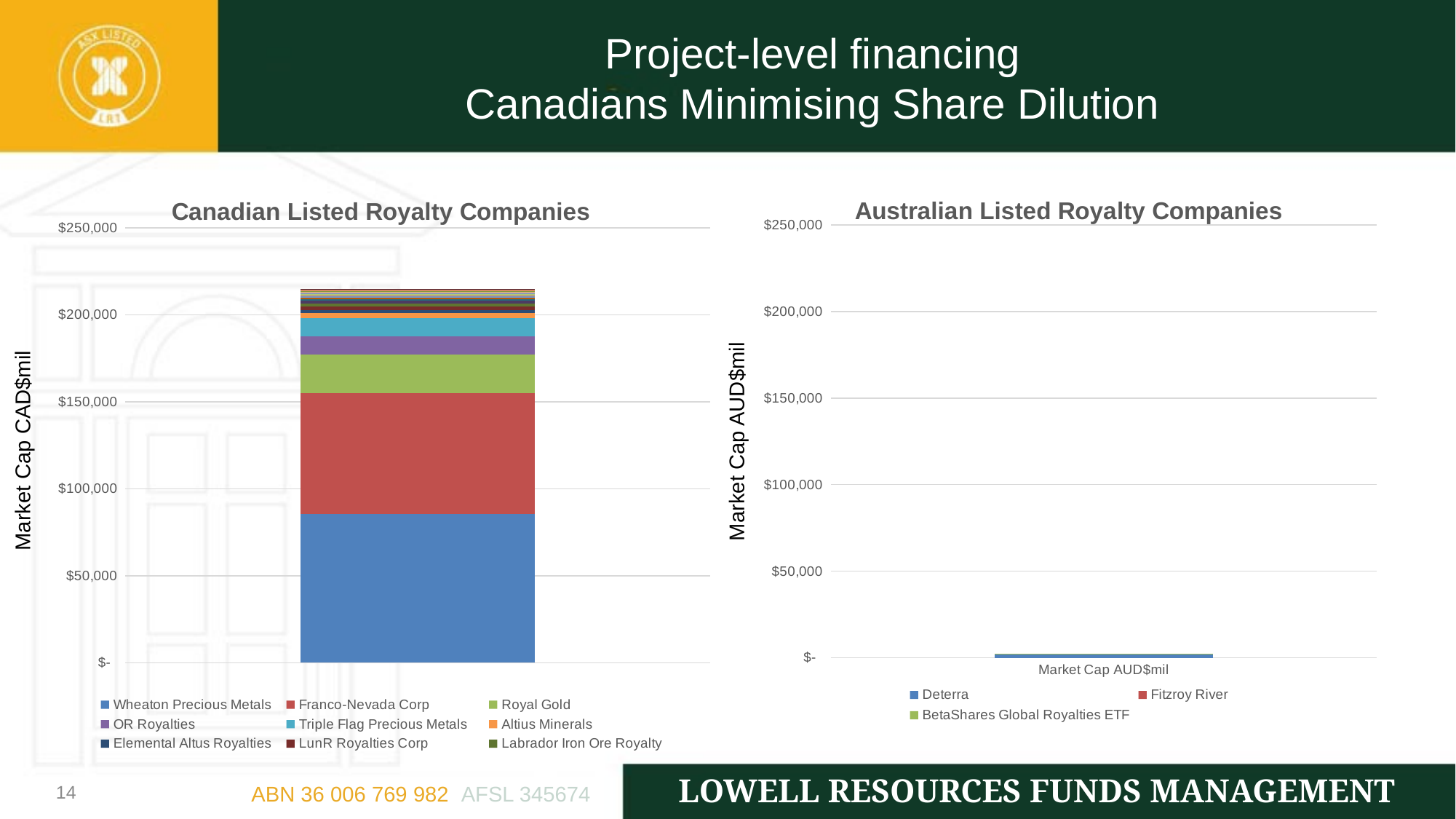
What kind of chart is the Canadian Listed Royalty Companies chart? stacked bar chart What kind of chart is the Australian Listed Royalty Companies chart? stacked bar chart In the Australian Listed Royalty Companies chart, how many series does the legend list? 3 What is the y-axis label of the Canadian Listed Royalty Companies chart? Market Cap CAD$mil In the Canadian Listed Royalty Companies chart, is the total height of the stacked bar greater or less than $200,000? greater In the Canadian Listed Royalty Companies chart, how many series does the legend list? 9 In the Canadian Listed Royalty Companies chart, is the Wheaton Precious Metals segment greater or less than $50,000? greater In the Australian Listed Royalty Companies chart, is the total height of the stacked bar greater or less than $50,000? less In the Canadian Listed Royalty Companies chart, which segment is larger: Franco-Nevada Corp or Royal Gold? Franco-Nevada Corp What is the y-axis label of the Australian Listed Royalty Companies chart? Market Cap AUD$mil In the Canadian Listed Royalty Companies chart, which company has the largest segment of the stacked bar? Wheaton Precious Metals